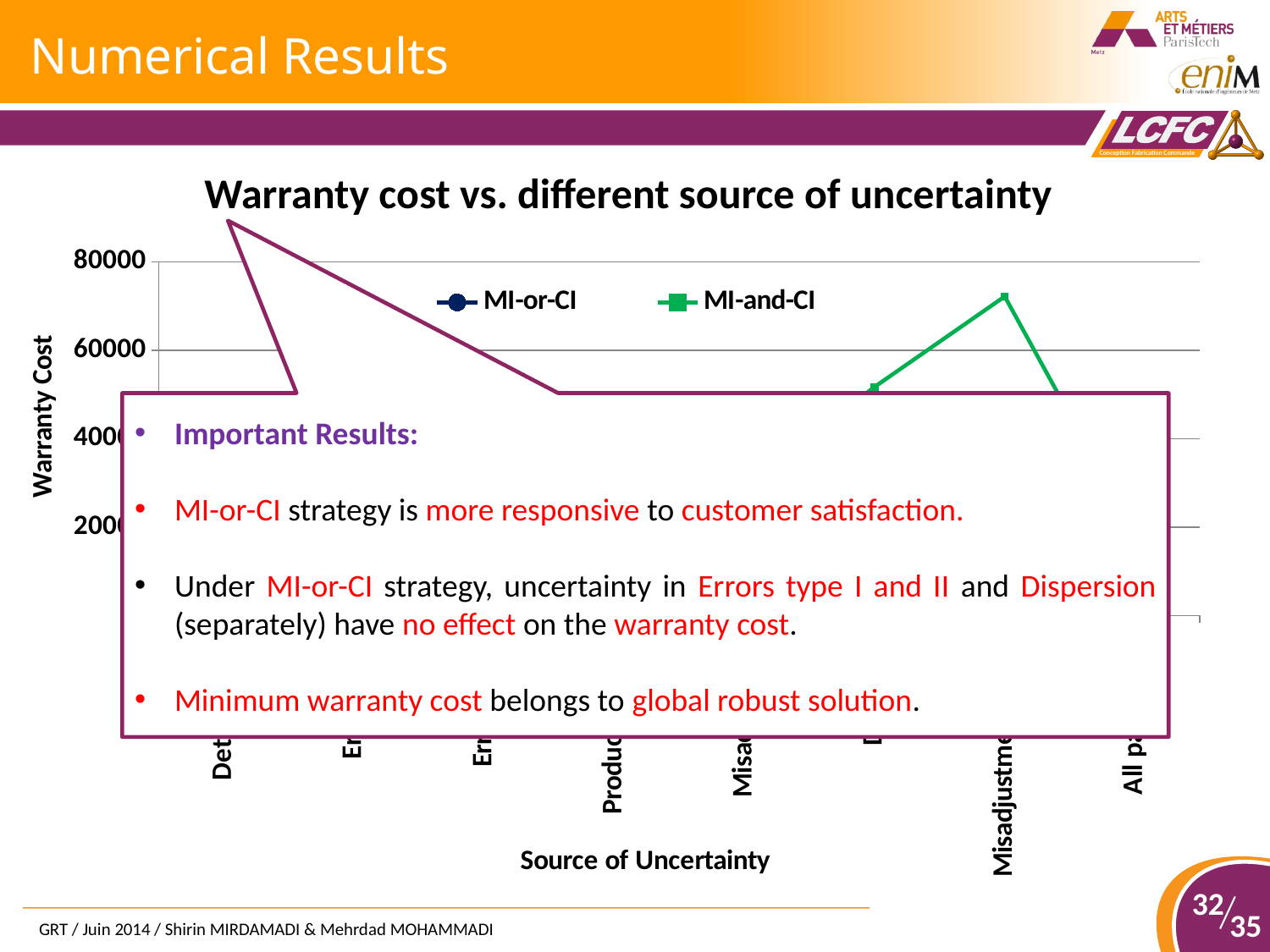
What is the highest tick value shown on the vertical axis of the chart? 80000 What is the label of the vertical axis of the chart? Warranty Cost What kind of chart is shown on the slide? line chart What is the label of the horizontal axis of the chart? Source of Uncertainty Is the highest visible value of the MI-and-CI series greater or less than 60000? greater How many series does the chart legend list? 2